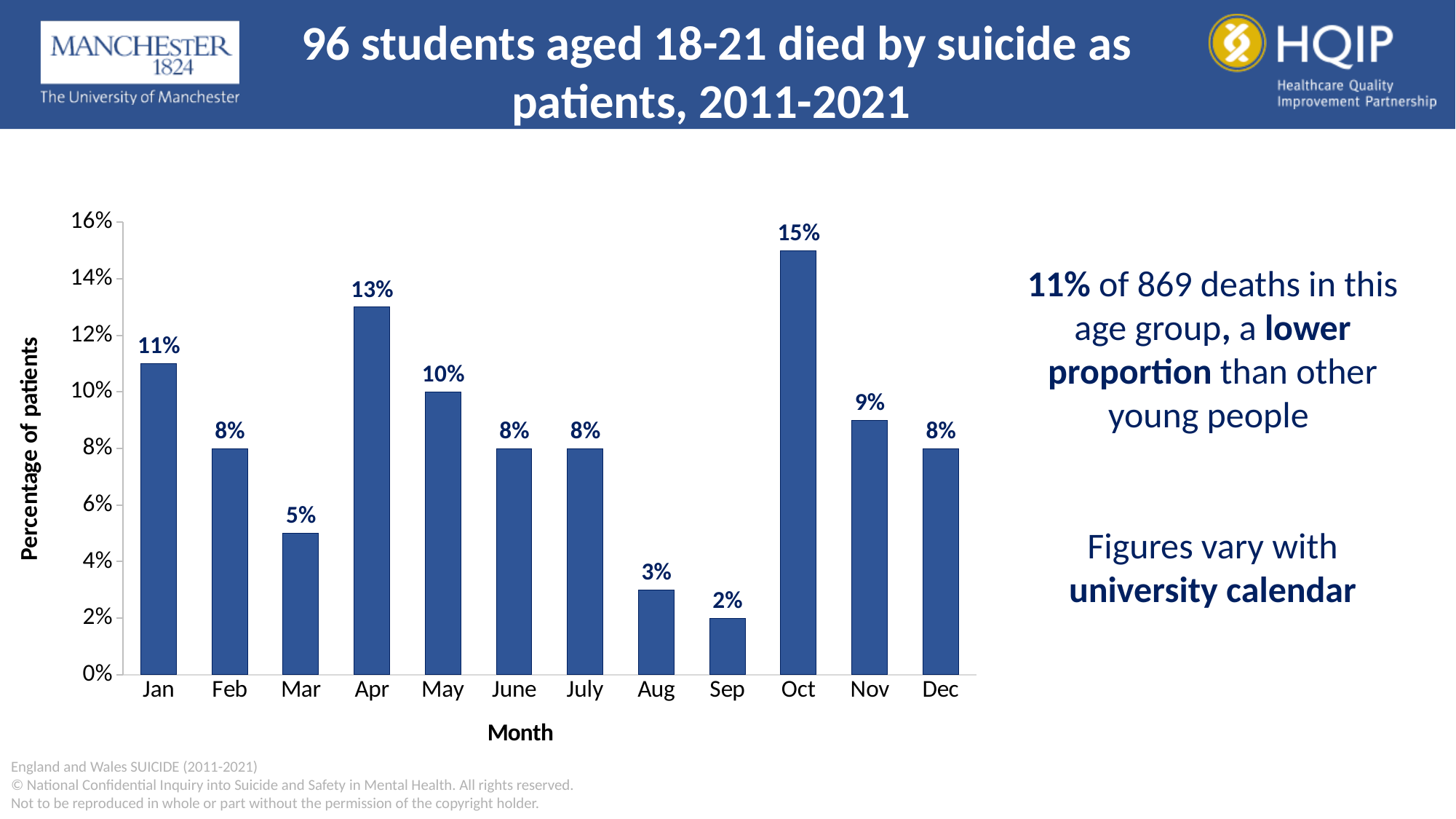
What percentage of patients is shown for April? 13% Which month has the lowest percentage of patients? Sep What is the label of the y axis of the chart? Percentage of patients Which month has the highest percentage of patients? Oct What percentage of patients is shown for September? 2% What kind of chart is shown on the slide? Bar chart Is the value for August greater or less than 4%? less What is the difference in percentage points between April and March? 8 Which month has a higher percentage of patients, January or November? Jan What percentage of patients is shown for October? 15% What is the difference in percentage points between October and September? 13 How many months are shown on the x axis of the chart? 12